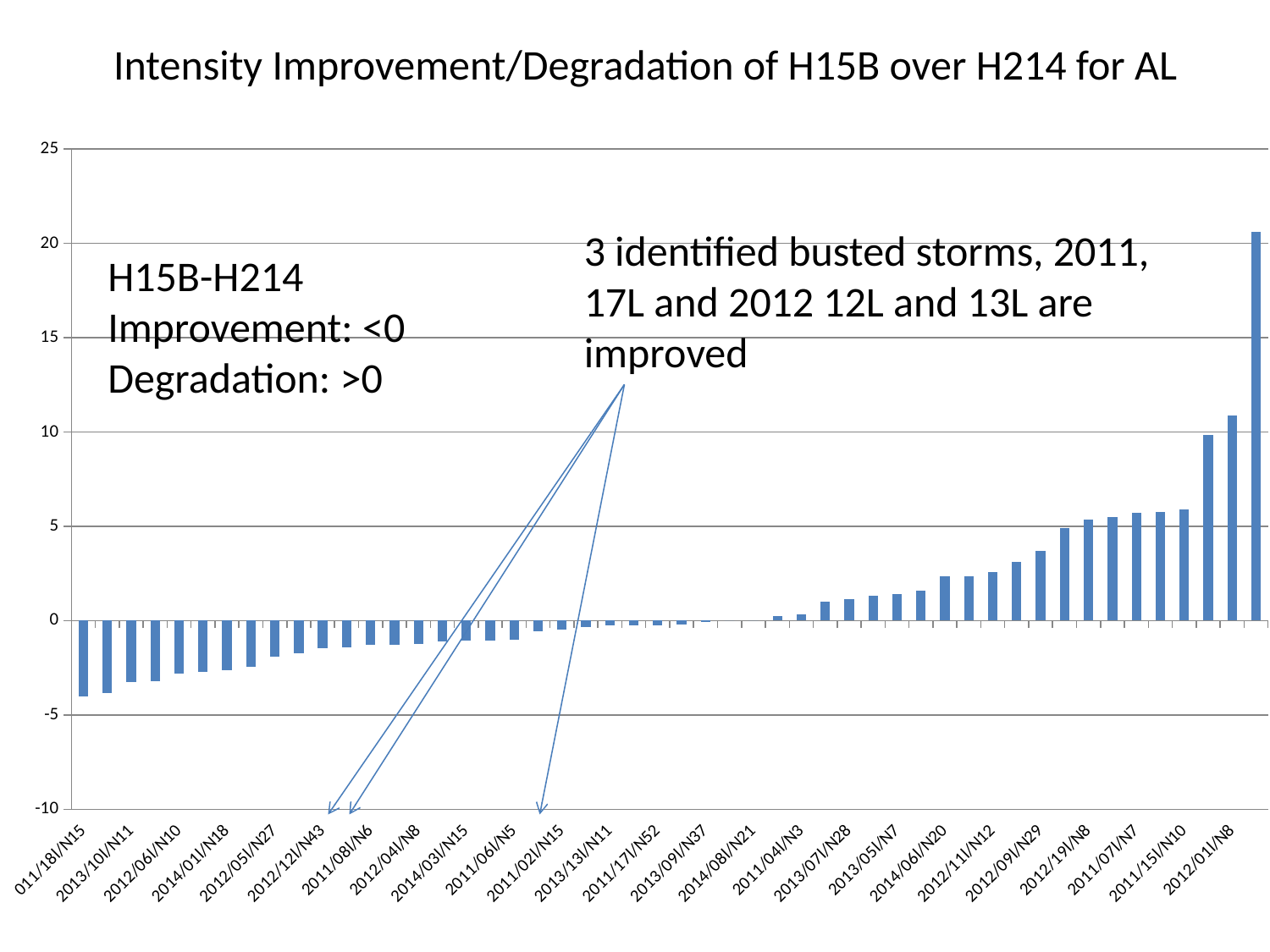
Is the value for 2013/10l/N11 greater or less than 0? less What is the highest value shown on the y axis? 25 Which is larger, the value for 011/18l/N15 or the value for 2012/01l/N8? 2012/01l/N8 What kind of chart is shown on the slide? bar chart What is the title of the chart? Intensity Improvement/Degradation of H15B over H214 for AL Is the value for 2012/01l/N8 greater or less than 10? greater Is the value for 011/18l/N15 greater or less than -5? greater Do the bar values rise or fall moving from left to right along the x axis? rise Which is larger, the value for 2012/06l/N10 or the value for 2011/15l/N10? 2011/15l/N10